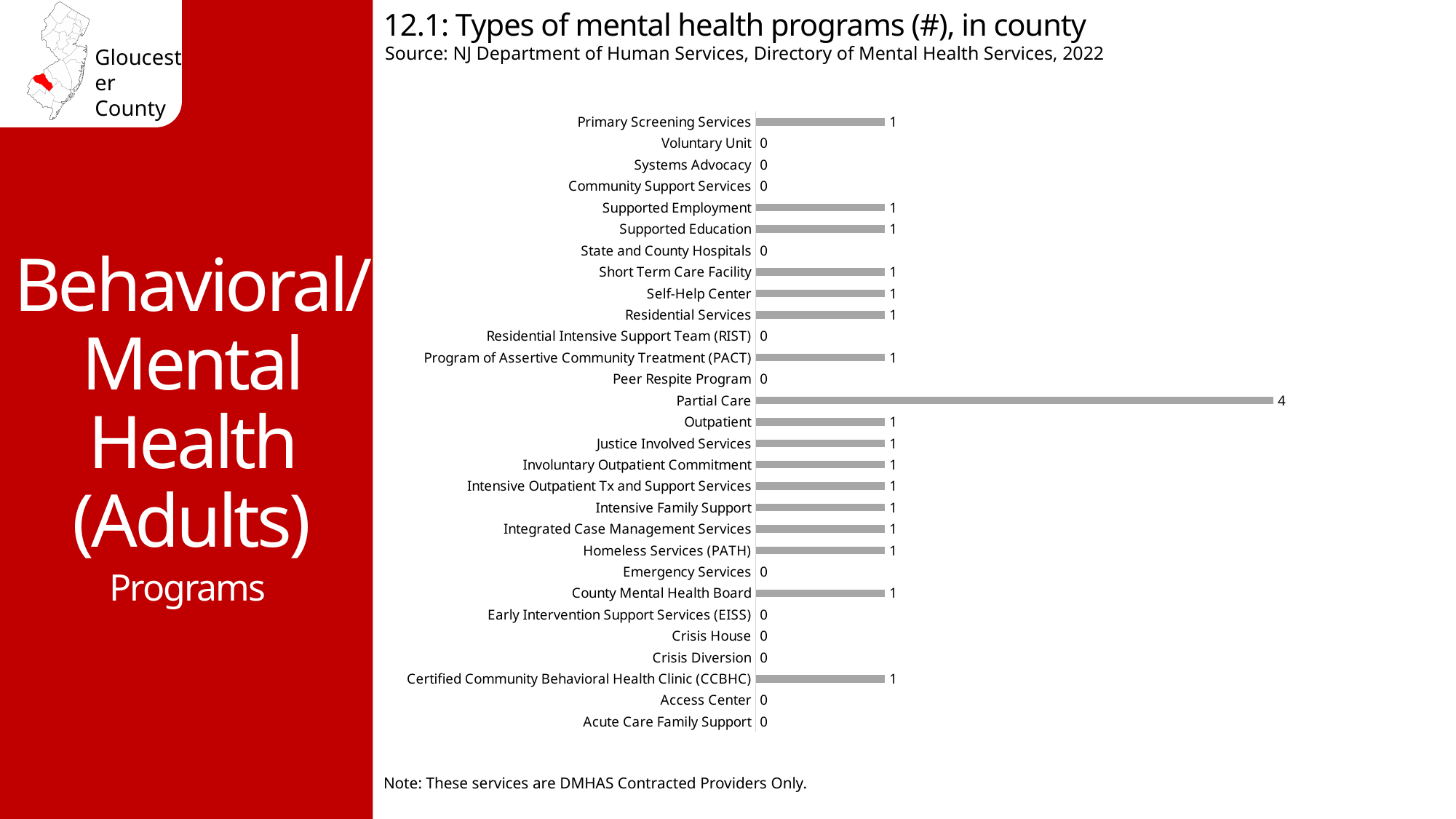
What is the difference between the values for Partial Care and Outpatient? 3 What is the title of the chart? 12.1: Types of mental health programs (#), in county How many program types are listed on the chart? 29 What is the value for Certified Community Behavioral Health Clinic (CCBHC)? 1 What is the source cited for the chart? NJ Department of Human Services, Directory of Mental Health Services, 2022 What is the value for Primary Screening Services? 1 How many program types have a value of 0? 12 What kind of chart is shown on the slide? Bar chart Which program type has the highest value? Partial Care What is the value for Partial Care? 4 Which is larger, the value for Supported Employment or the value for Voluntary Unit? Supported Employment What is the value for Emergency Services? 0